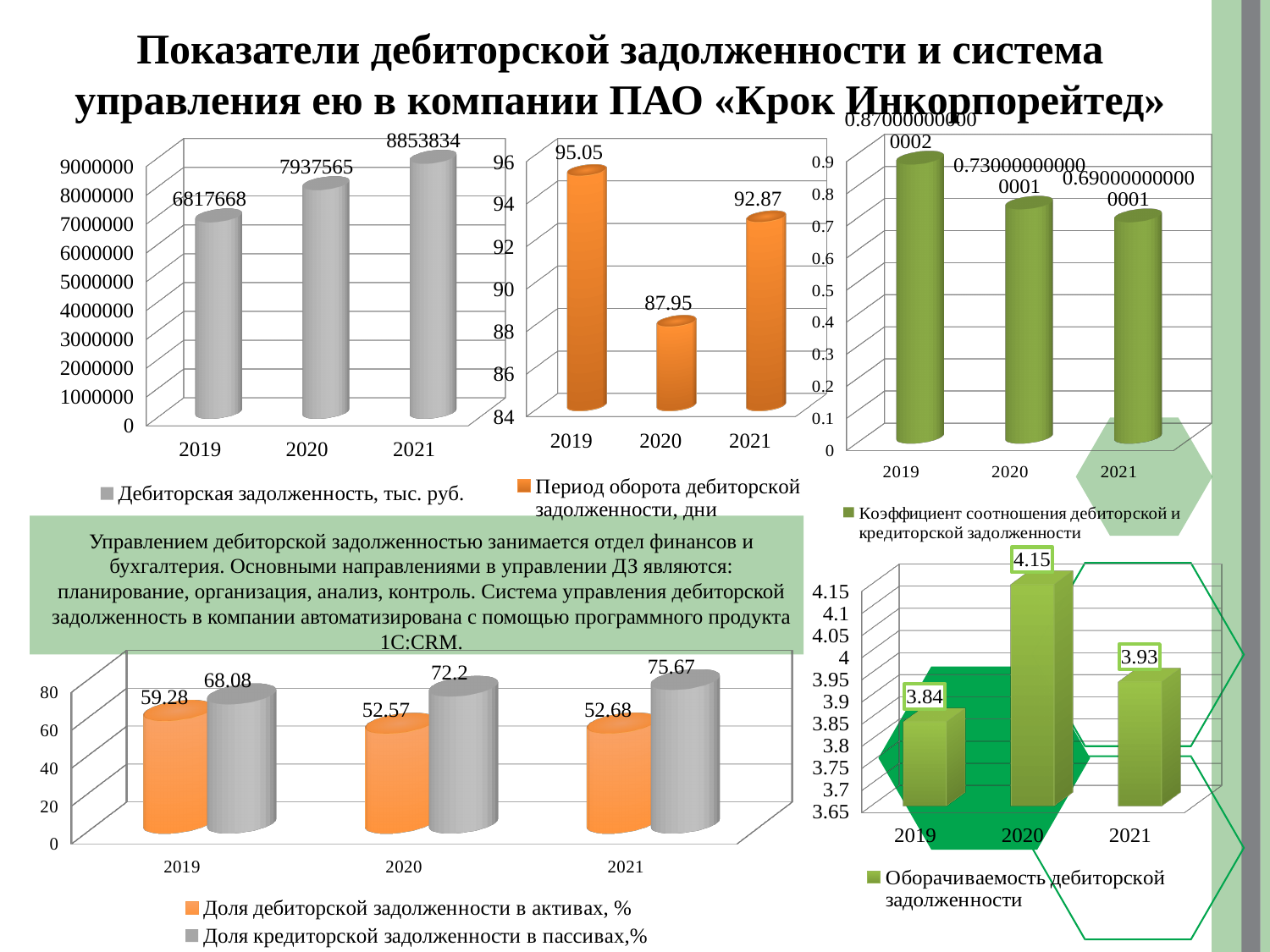
In the chart 'Коэффициент соотношения дебиторской и кредиторской задолженности', which year has the highest value? 2019 In the bottom-left chart, what is the value of 'Доля кредиторской задолженности в пассивах,%' for 2020? 72.2 In the chart 'Период оборота дебиторской задолженности, дни', what is the difference between the 2019 and 2021 values? 2.18 In the chart 'Период оборота дебиторской задолженности, дни', which year has the highest value? 2019 In the chart 'Коэффициент соотношения дебиторской и кредиторской задолженности', is the value for 2021 greater or less than 0.8? less In the chart 'Период оборота дебиторской задолженности, дни', what is the value for 2020? 87.95 In the chart 'Дебиторская задолженность, тыс. руб.', what is the value for 2021? 8853834 In the chart 'Оборачиваемость дебиторской задолженности', what is the value for 2020? 4.15 In the bottom-left chart, how many series does the legend list? 2 In the bottom-left chart, which is larger for 2019: 'Доля дебиторской задолженности в активах, %' or 'Доля кредиторской задолженности в пассивах,%'? Доля кредиторской задолженности в пассивах,% In the chart 'Дебиторская задолженность, тыс. руб.', which year has the lowest value? 2019 In the chart 'Дебиторская задолженность, тыс. руб.', do the values rise or fall from 2019 to 2021? rise